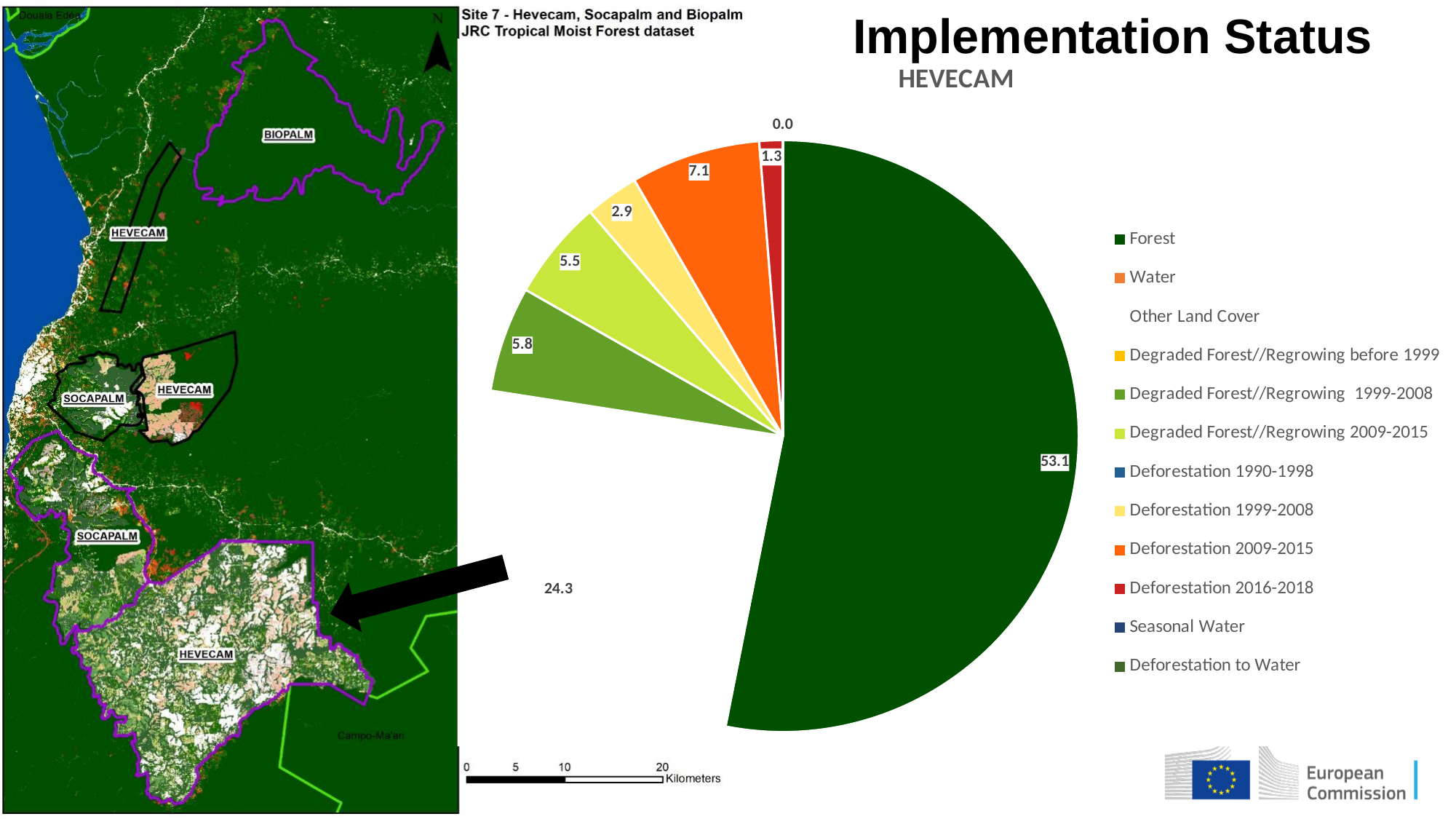
What value is shown for Deforestation 1999-2008 in the pie chart? 2.9 Which is larger in the pie chart, Deforestation 2009-2015 or Deforestation 1999-2008? Deforestation 2009-2015 Which category has the largest slice in the pie chart? Forest Which is larger in the pie chart, Degraded Forest//Regrowing 1999-2008 or Degraded Forest//Regrowing 2009-2015? Degraded Forest//Regrowing 1999-2008 What value is shown for Other Land Cover in the pie chart? 24.3 What kind of chart is shown on the slide? pie chart What is the difference between the Deforestation 2009-2015 value and the Deforestation 1999-2008 value in the pie chart? 4.2 What value is shown for Deforestation 2016-2018 in the pie chart? 1.3 What value is shown for Deforestation 2009-2015 in the pie chart? 7.1 What value is shown for Forest in the pie chart? 53.1 How many entries does the legend of the pie chart list? 12 What is the difference between the Forest value and the Other Land Cover value in the pie chart? 28.8